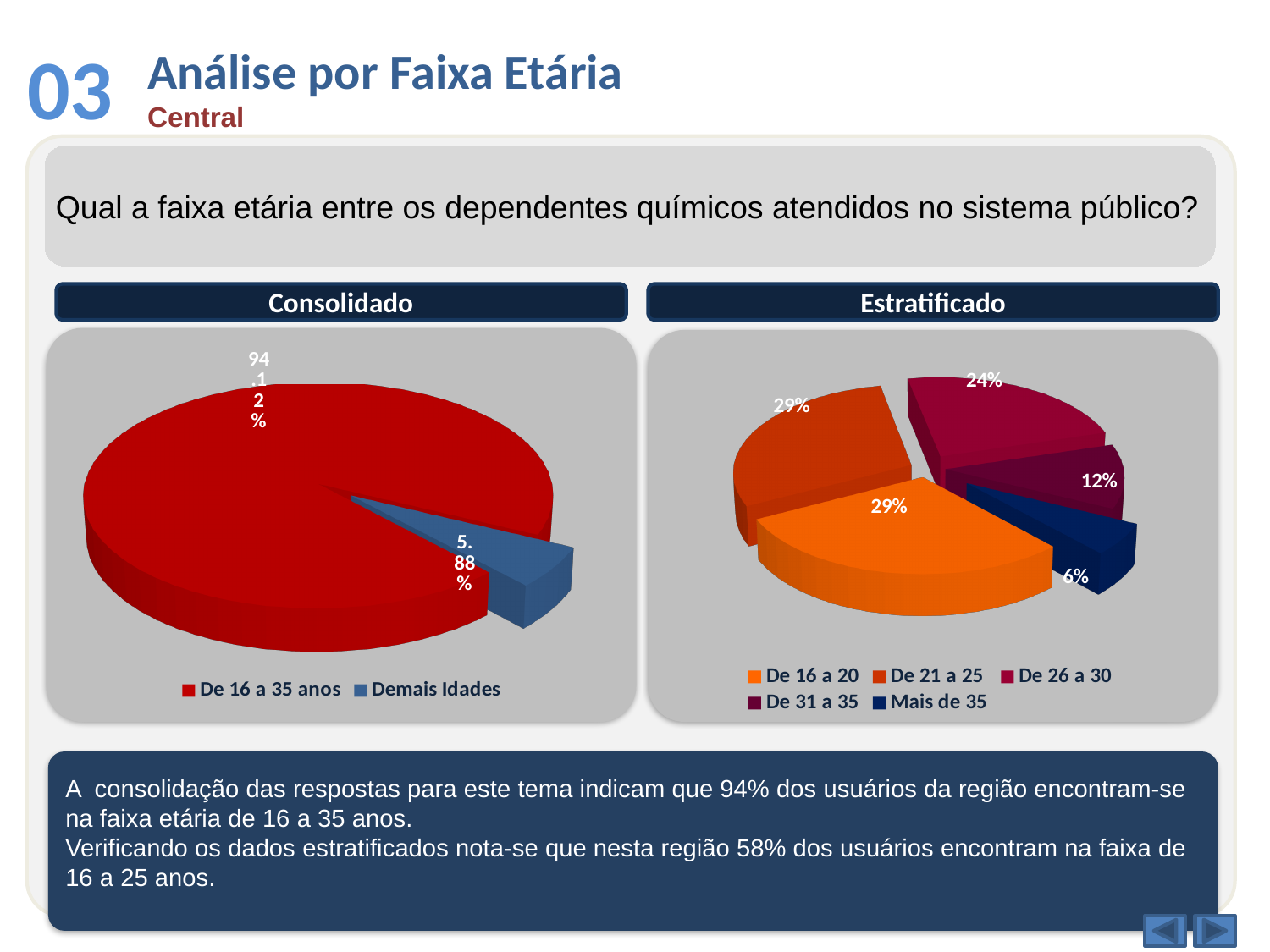
What kind of chart is the Estratificado chart? Pie chart In the Consolidado chart, what share is shown for Demais Idades? 5.88% In the Estratificado chart, which category has the smallest slice? Mais de 35 In the Estratificado chart, what share is shown for De 31 a 35? 12% In the Estratificado chart, what share is shown for Mais de 35? 6% In the Consolidado chart, which category has the largest slice? De 16 a 35 anos In the Estratificado chart, which is larger, the share for De 31 a 35 or the share for Mais de 35? De 31 a 35 In the Estratificado chart, what is the difference between the shares for De 26 a 30 and De 31 a 35? 12% In the Consolidado chart, what share is shown for De 16 a 35 anos? 94.12% In the Consolidado chart, how many series does the legend list? 2 In the Estratificado chart, what share is shown for De 26 a 30? 24% In the Estratificado chart, how many categories does the legend list? 5